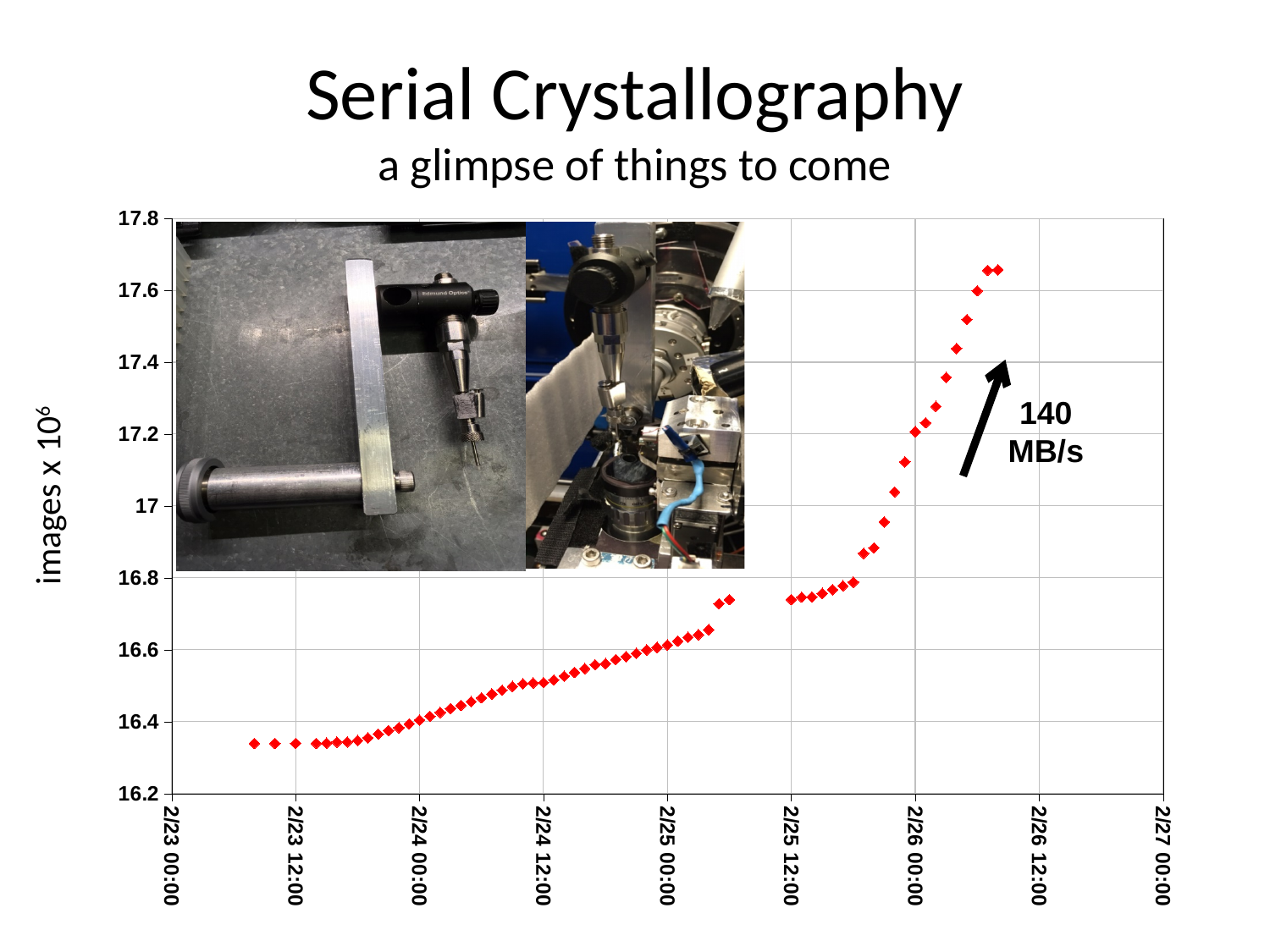
At which end of the time range do the highest values occur, the beginning (2/23) or the end (2/26)? the end (2/26) Is the value plotted at 2/24 12:00 greater or less than 16.6? less Is the value plotted at 2/25 12:00 greater or less than 16.8? less Is the value plotted at 2/26 00:00 greater or less than 17? greater What is the label on the y axis of the chart? images x 10^6 What rate is written next to the black arrow on the chart? 140 MB/s What kind of chart is shown on the slide? scatter chart Which is larger: the value plotted at 2/25 00:00 or the value plotted at 2/26 00:00? 2/26 00:00 What is the highest value shown on the y axis of the chart? 17.8 Do the plotted values rise or fall over time along the x axis? rise